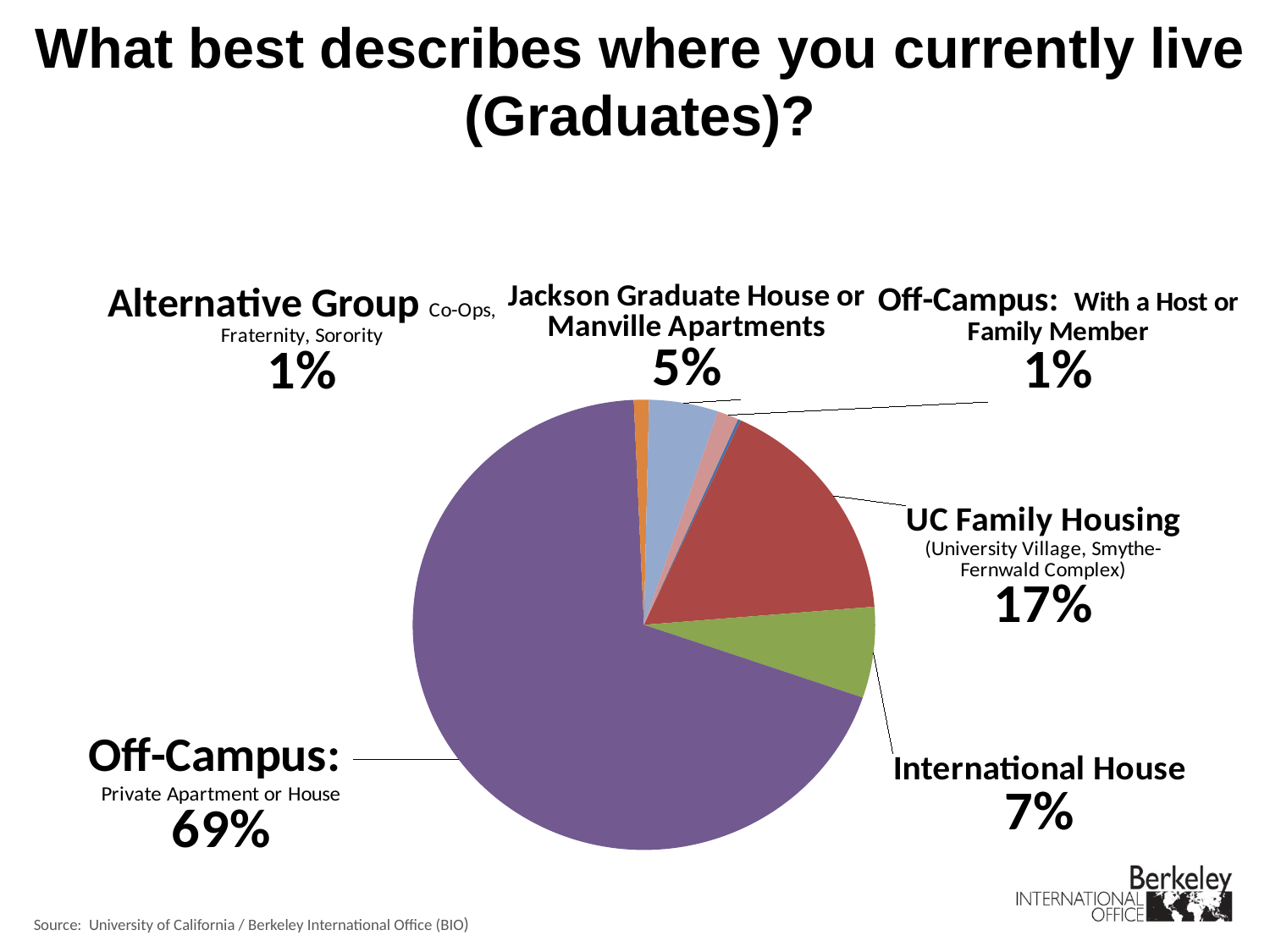
What is the title of the chart on the slide? What best describes where you currently live (Graduates)? What is the difference in percentage points between Off-Campus: Private Apartment or House and UC Family Housing? 52% What share of graduates live in Jackson Graduate House or Manville Apartments? 5% What kind of chart is shown on the slide? pie chart What is the difference in percentage points between UC Family Housing and International House? 10% Which category has the largest slice of the pie? Off-Campus: Private Apartment or House What share of graduates live in UC Family Housing? 17% What share of graduates live in an Alternative Group (Co-Ops, Fraternity, Sorority)? 1% Which is larger: the share for International House or the share for Jackson Graduate House or Manville Apartments? International House How many categories are shown in the pie chart? 6